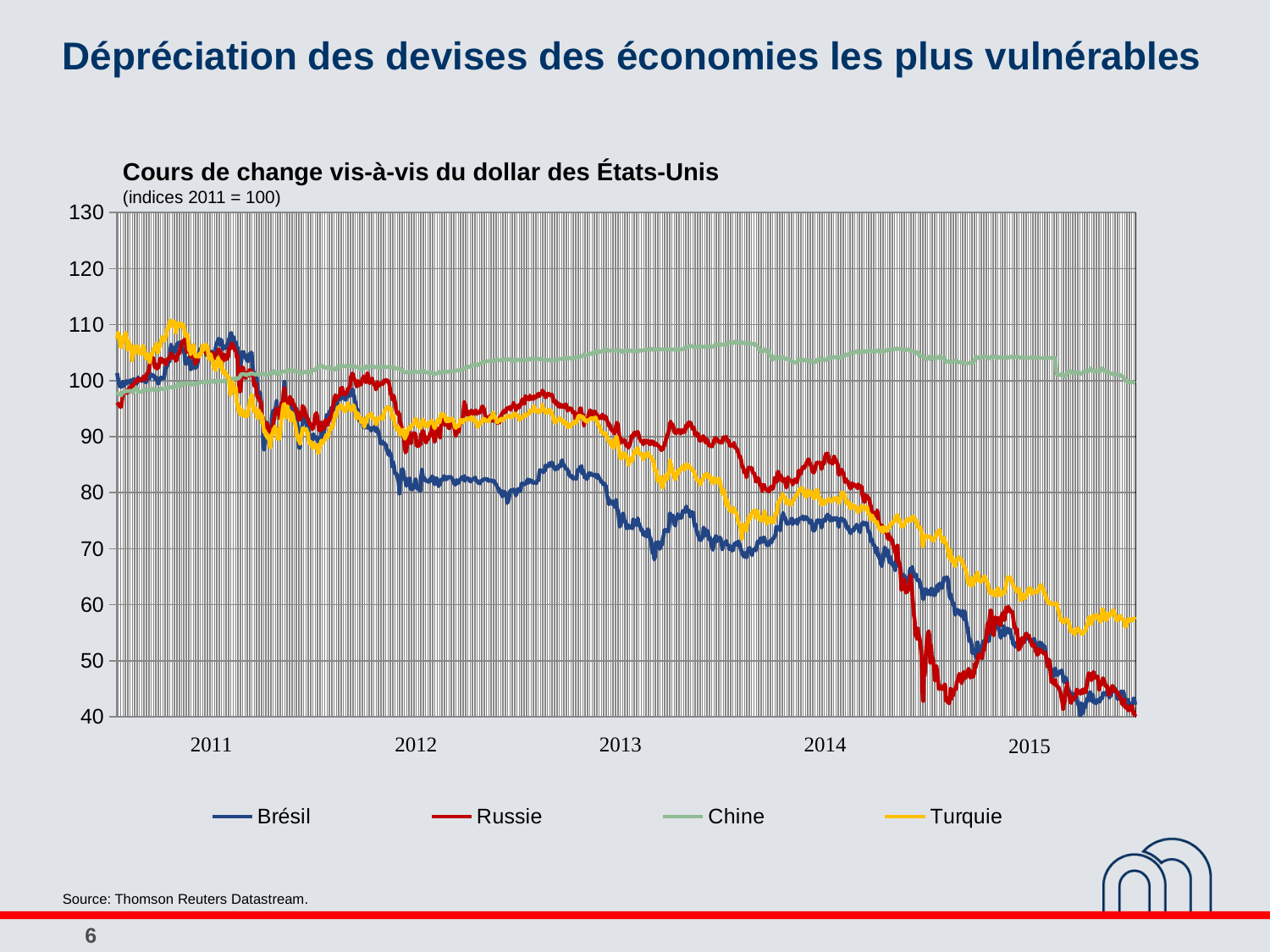
At the end of 2015, which is higher, Turquie or Russie? Turquie How many series does the legend list? 4 Which series has the highest value at the end of 2015? Chine Which countries are listed in the chart legend? Brésil, Russie, Chine, Turquie What is the title of the chart? Cours de change vis-à-vis du dollar des États-Unis Is the value for Turquie at the end of 2015 greater or less than 70? less At the end of 2015, which is higher, Chine or Brésil? Chine Is the value for Chine during 2013 greater or less than 100? greater Is the value for Brésil at the end of 2015 greater or less than 50? less What kind of chart is shown on the slide? line chart Does the Brésil series rise or fall overall from 2011 to 2015? fall How many years are labelled on the x axis? 5